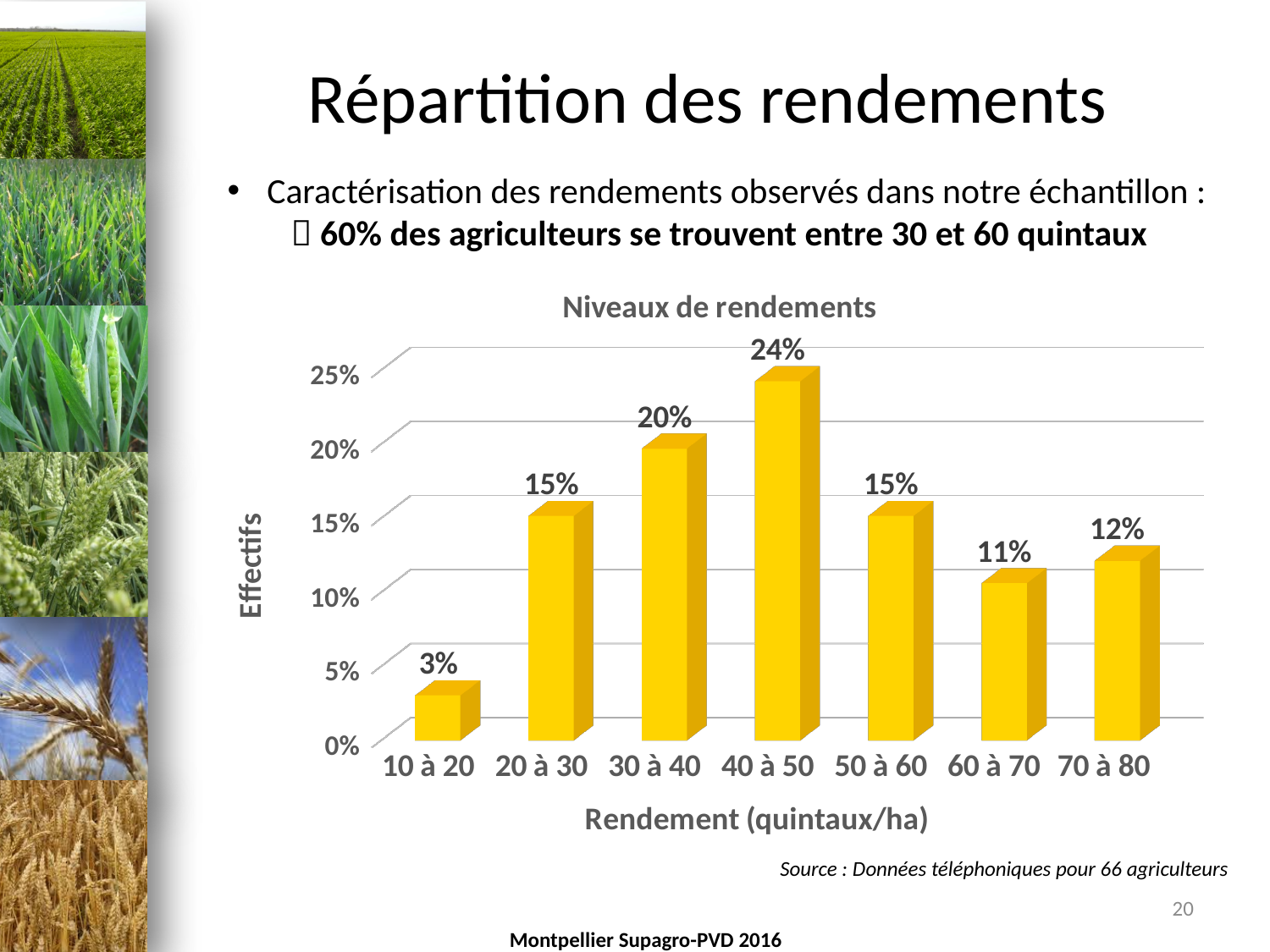
What is the title of the chart? Niveaux de rendements What is the value for the 10 à 20 category? 3% What is the difference between the values for 40 à 50 and 30 à 40? 4% What is the difference between the values for 70 à 80 and 60 à 70? 1% What is the value for the 70 à 80 category? 12% Is the value for 60 à 70 greater or less than 15%? less What is the value for the 40 à 50 category? 24% What kind of chart is shown? bar chart Which is larger, the value for 30 à 40 or the value for 50 à 60? 30 à 40 Which category has the lowest value? 10 à 20 How many categories are shown on the x axis? 7 Which category has the highest value? 40 à 50